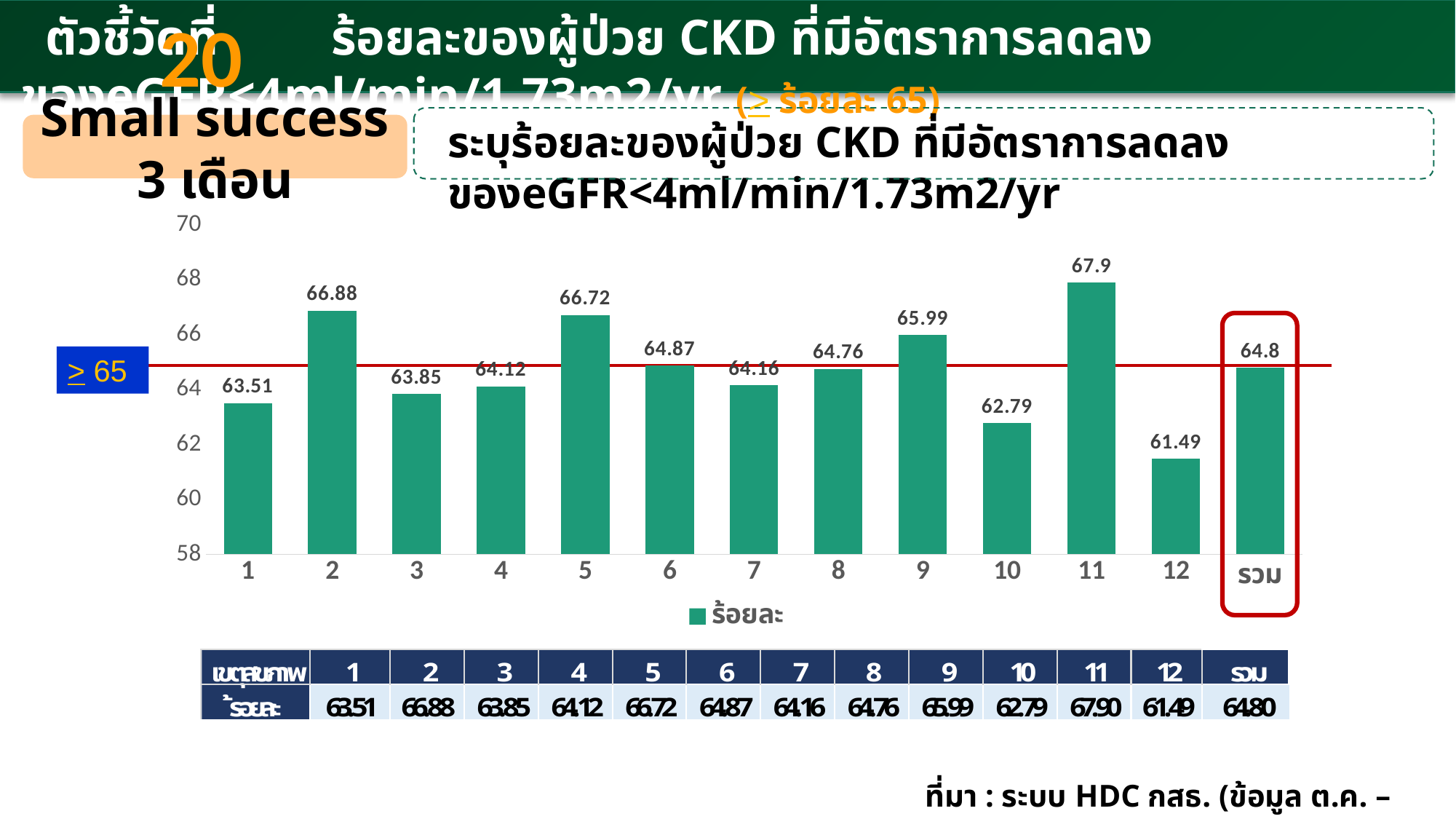
Is the value for category 10 greater or less than 64? less How many bars are plotted in the chart? 13 What type of chart is shown on the slide? bar chart What is the difference between the values for category 11 and category 12? 6.41 What is the value for category 2? 66.88 What is the value for category 12? 61.49 What is the legend entry for the series in the chart? ร้อยละ Which is larger, the value for category 5 or the value for category 9? 5 What is the value for the รวม bar? 64.8 How many series does the legend list? 1 Which category has the highest value? 11 Which category has the lowest value? 12